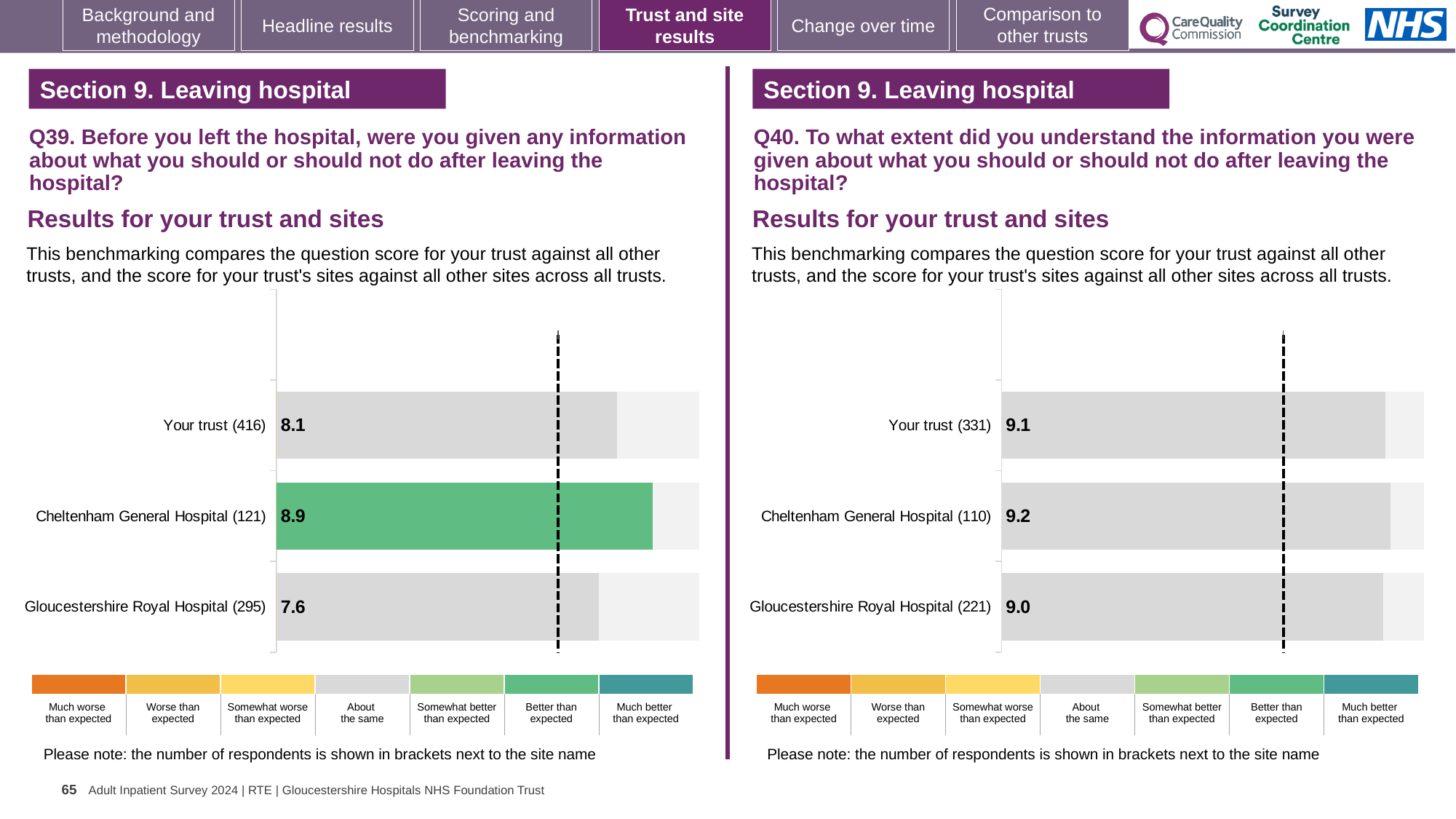
In the Q39 chart on the left, how many respondents are shown in brackets for Your trust? 416 In the Q39 chart on the left, what is the difference between the scores for Cheltenham General Hospital and Gloucestershire Royal Hospital? 1.3 In the Q40 chart on the right, how many bars are plotted? 3 In the Q39 chart on the left, which site or trust has the lowest score? Gloucestershire Royal Hospital What kind of chart is used in the Q39 chart on the left? Bar chart In the Q40 chart on the right, what is the score for Gloucestershire Royal Hospital? 9.0 In the Q39 chart on the left, what is the score for Your trust? 8.1 In the Q39 chart on the left, which site or trust has the highest score? Cheltenham General Hospital In the Q39 chart on the left, what is the score for Gloucestershire Royal Hospital? 7.6 In the Q39 chart on the left, what is the score for Cheltenham General Hospital? 8.9 In the Q40 chart on the right, what is the score for Your trust? 9.1 In the Q40 chart on the right, which site or trust has the highest score? Cheltenham General Hospital